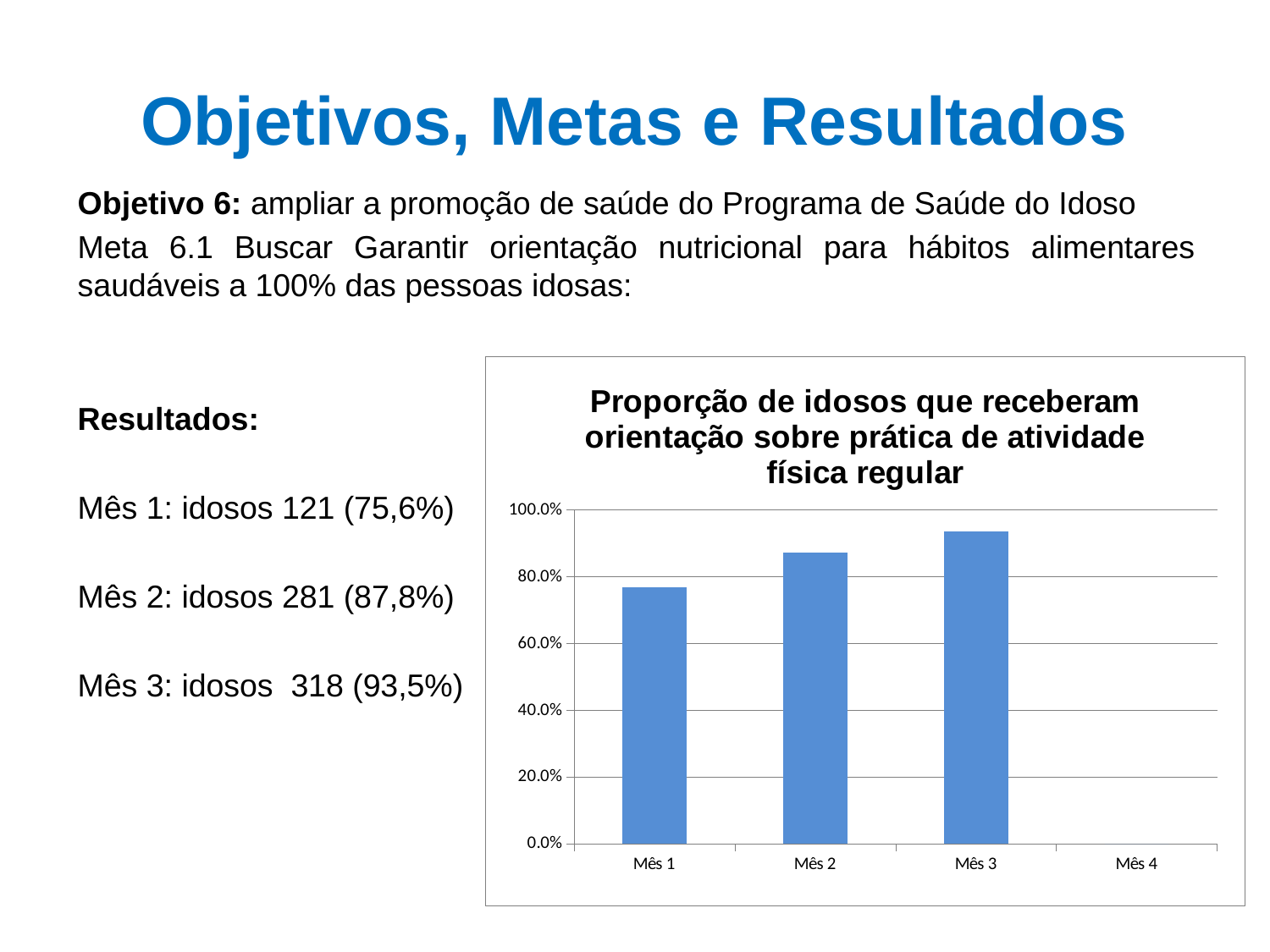
Is the value for Mês 2 greater or less than 80.0%? greater Which is larger, the value for Mês 2 or the value for Mês 1? Mês 2 What is the title of the chart? Proporção de idosos que receberam orientação sobre prática de atividade física regular What kind of chart is shown on the slide? bar chart Which month has the tallest bar in the chart? Mês 3 Is the value for Mês 1 greater or less than 80.0%? less Is the value for Mês 1 greater or less than 60.0%? greater Do the values rise or fall from Mês 1 to Mês 3? rise Among Mês 1, Mês 2 and Mês 3, which month has the lowest value in the chart? Mês 1 What colour are the bars in the chart? blue How many categories are shown on the x axis of the chart? 4